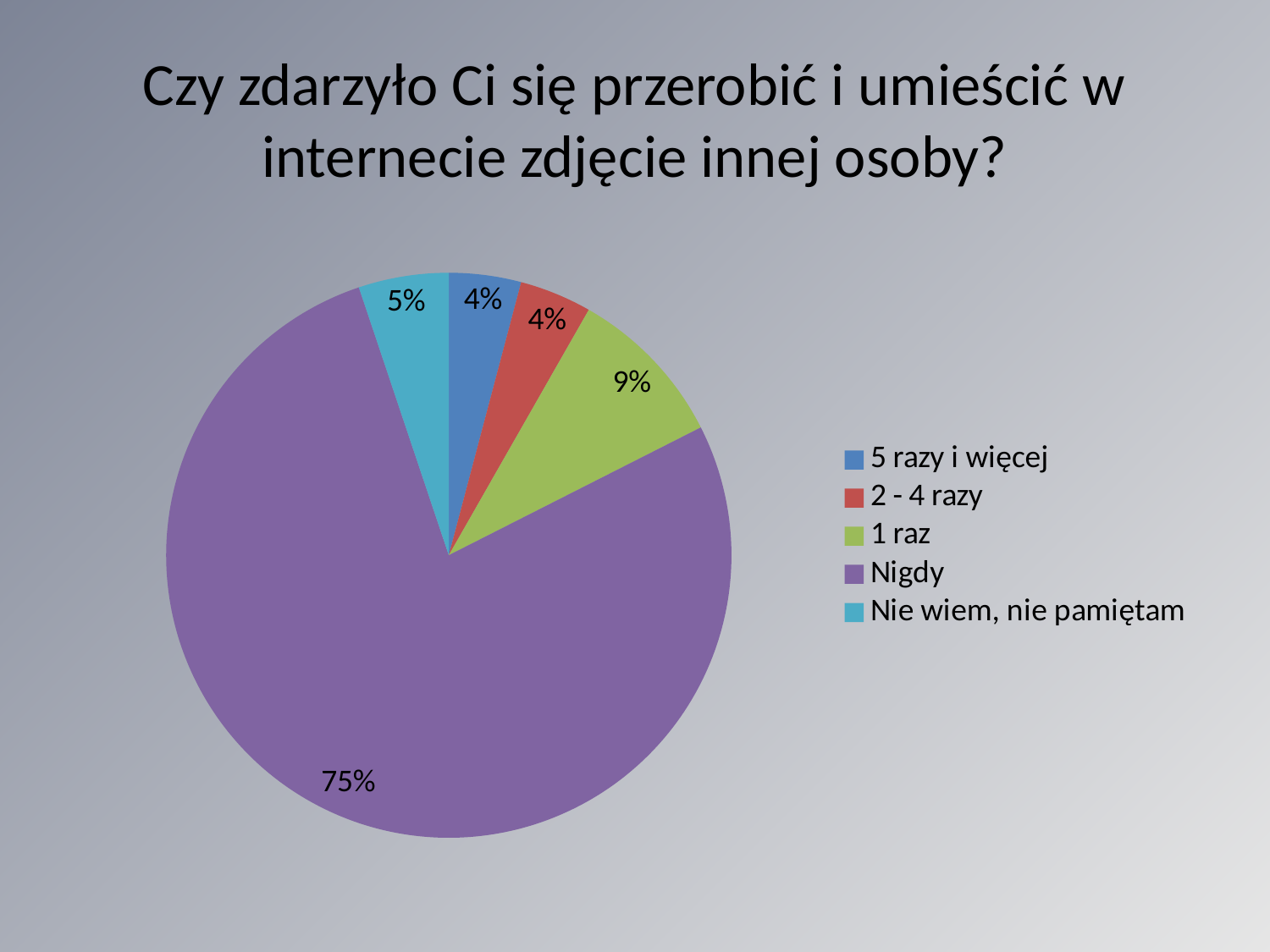
What kind of chart is shown on the slide? pie chart What share of the pie does "Nigdy" have? 75% How many categories does the legend list? 5 What is the value for "5 razy i więcej"? 4% What is the difference between the values for "Nigdy" and "1 raz"? 66% What is the value for "1 raz"? 9% Which category has the largest slice? Nigdy Which is larger, the value for "1 raz" or the value for "Nie wiem, nie pamiętam"? 1 raz What is the value for "Nie wiem, nie pamiętam"? 5% What is the value for "2 - 4 razy"? 4% What colour is the slice for "Nigdy"? purple What is the difference between the values for "1 raz" and "Nie wiem, nie pamiętam"? 4%